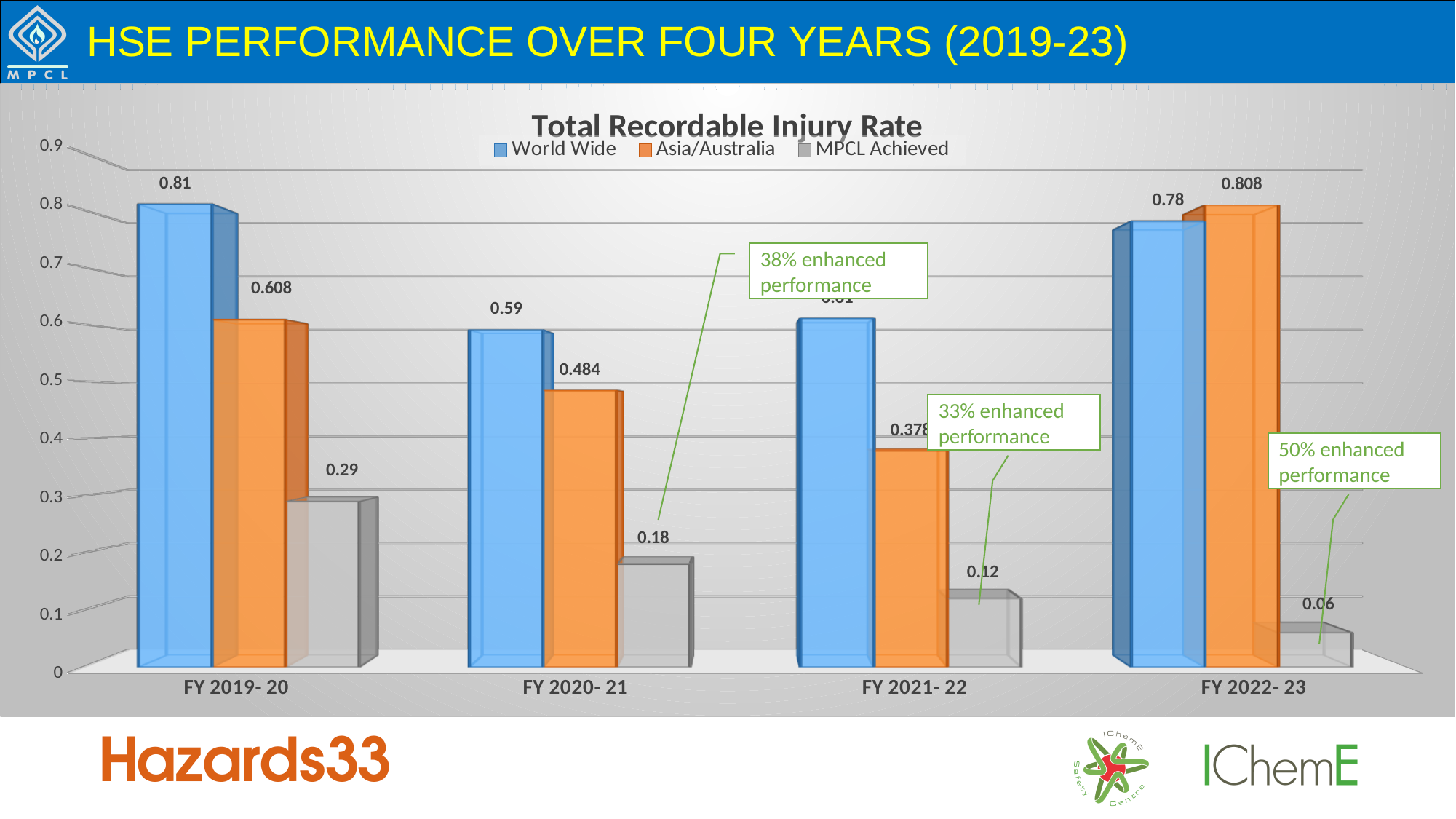
In which fiscal year is the Asia/Australia value highest? FY 2022-23 Is the World Wide value for FY 2021-22 greater or less than 0.5? greater Which is larger for FY 2022-23, the World Wide value or the Asia/Australia value? Asia/Australia In which fiscal year is the MPCL Achieved value lowest? FY 2022-23 What is the MPCL Achieved value for FY 2022-23? 0.06 How many series does the legend list? 3 What is the Asia/Australia value for FY 2020-21? 0.484 What is the difference between the World Wide and MPCL Achieved values for FY 2019-20? 0.52 What is the title of the chart? Total Recordable Injury Rate Does the MPCL Achieved value rise or fall from FY 2019-20 to FY 2022-23? fall What is the World Wide value for FY 2022-23? 0.78 What is the MPCL Achieved value for FY 2019-20? 0.29